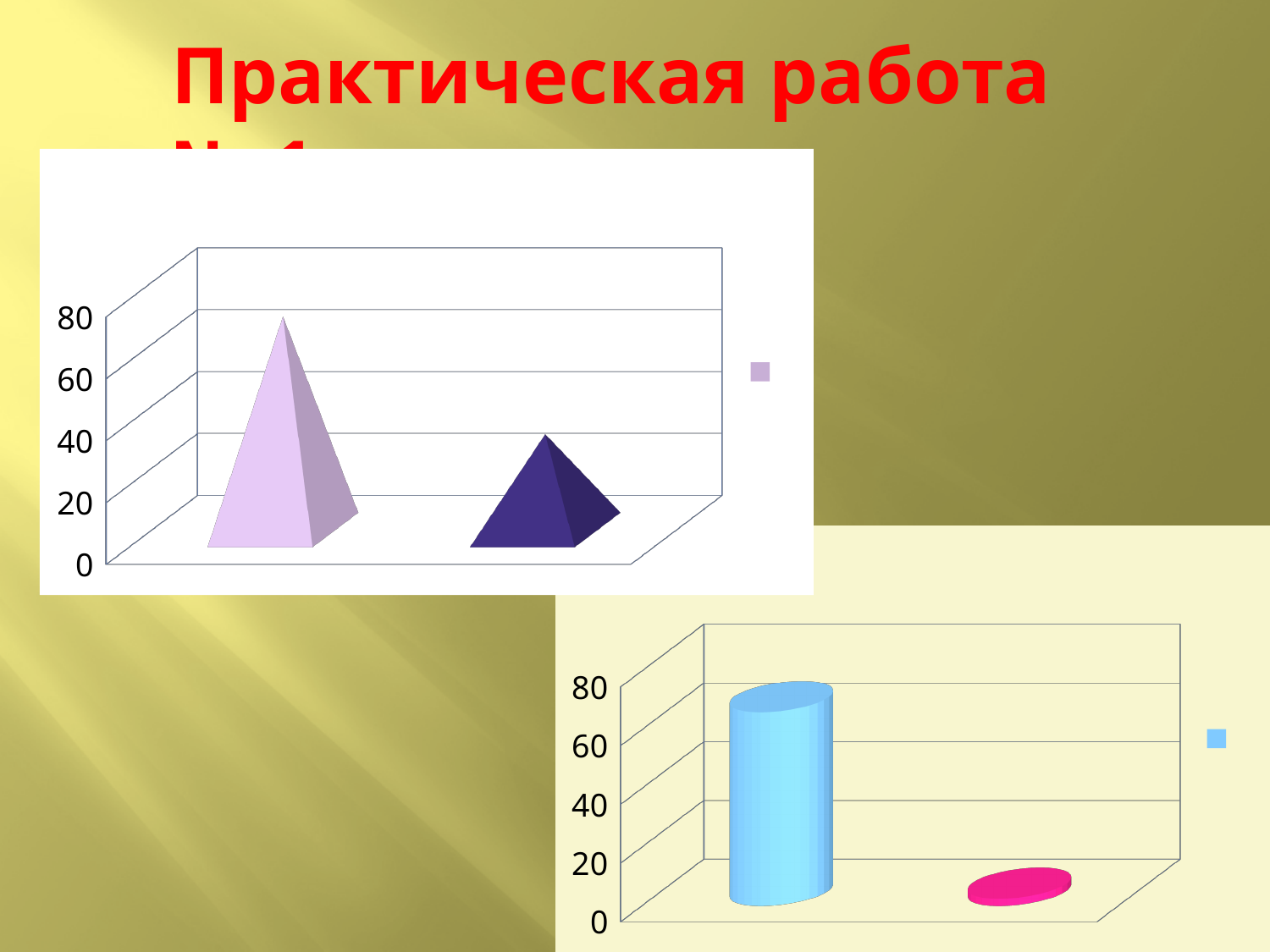
In the top-left chart, is the value of the right (dark purple) bar greater or less than 60? less How many series entries does the legend of the bottom-right chart show? 1 What kind of chart is the bottom-right chart? bar chart In the bottom-right chart, is the value of the blue cylinder greater or less than 60? greater In the top-left chart, is the value of the left (light purple) bar greater or less than 60? greater How many bars are plotted in the top-left chart? 2 What kind of chart is the top-left chart? bar chart In the top-left chart, which bar is taller, the left one or the right one? the left one In the bottom-right chart, which bar is taller, the blue one or the pink one? the blue one What is the highest tick value shown on the vertical axis of the top-left chart? 80 How many bars are plotted in the bottom-right chart? 2